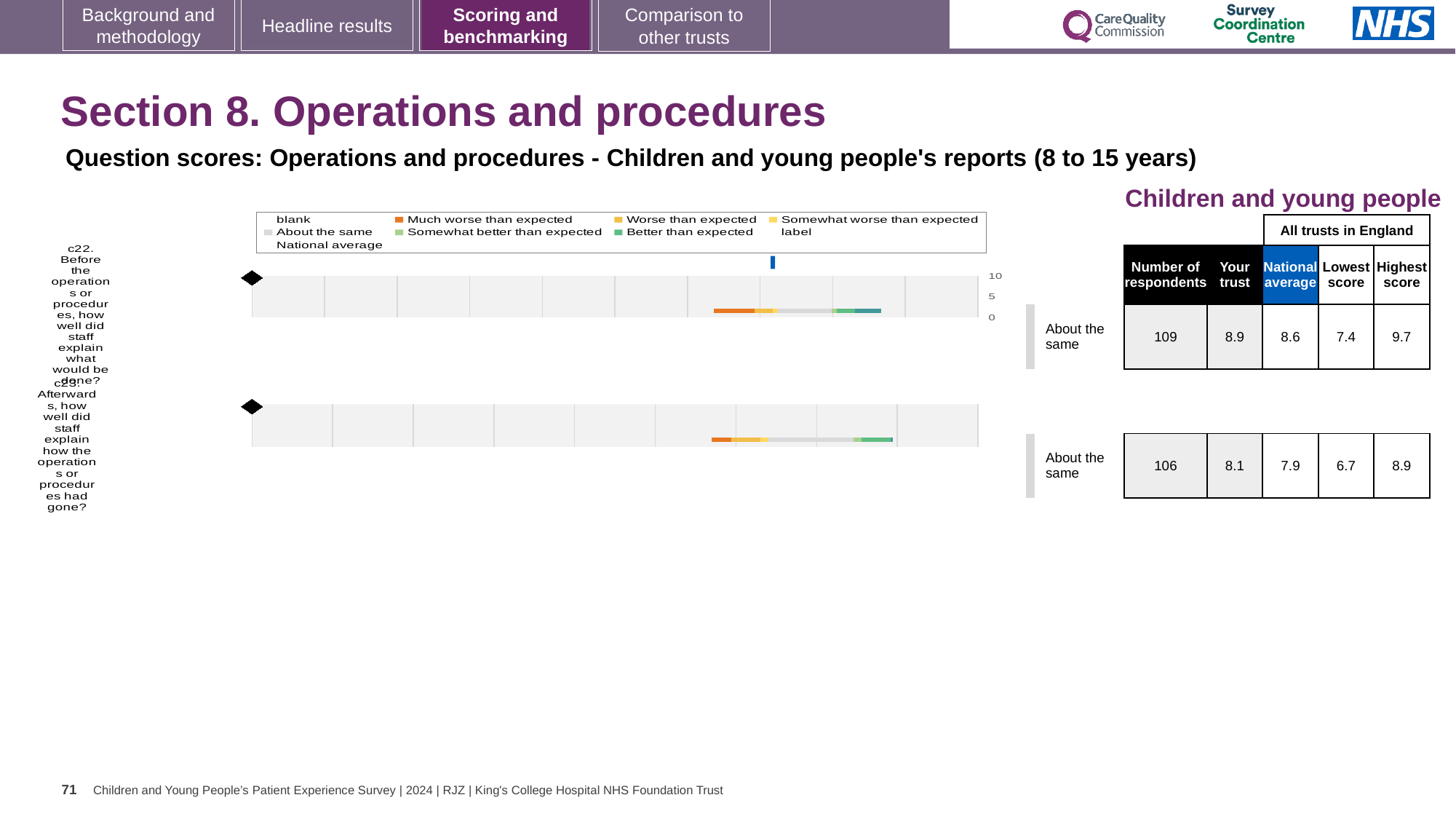
What is the difference between the highest and lowest scores across all trusts in England for question c22? 2.3 Which question has the higher 'Your trust' score, c22 or c23? c22 What is the national average score for question c22? 8.6 What benchmark category is shown for both questions c22 and c23? About the same What is the 'Your trust' score for question c23 (Afterwards, how well did staff explain how the operations or procedures had gone?)? 8.1 For question c22, is the trust's score higher or lower than the national average? higher What is the highest score among all trusts in England for question c23? 8.9 How many survey questions are plotted in the charts on this slide? 2 What kind of chart is used to show the question scores on this slide? bar chart What is the 'Your trust' score for question c22 (Before the operations or procedures, how well did staff explain what would be done?)? 8.9 What is the difference between the trust's score and the national average for question c23? 0.2 How many respondents answered question c22? 109